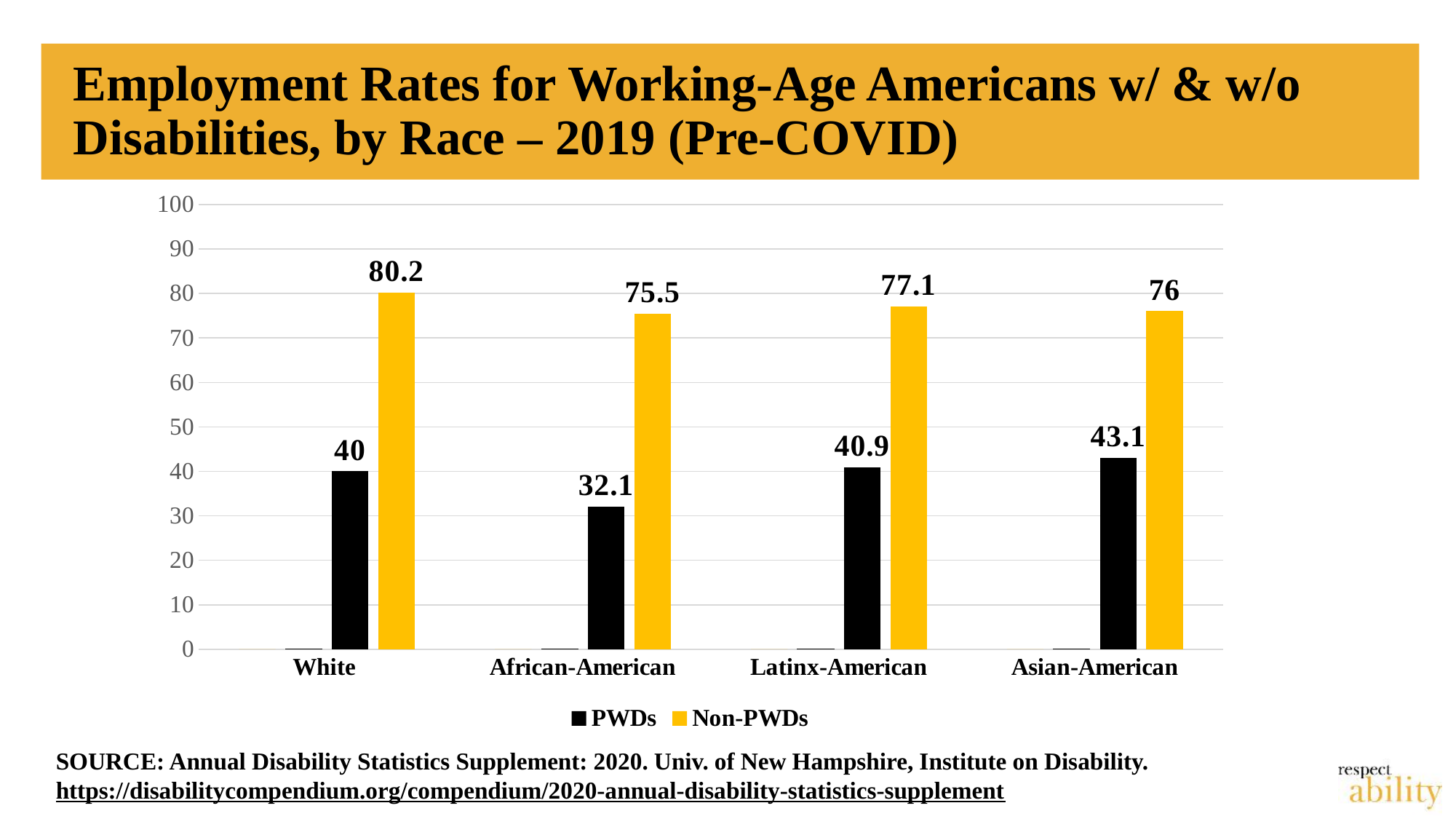
What is the employment rate for Non-PWDs in the Asian-American category? 76 Which race category has the lowest employment rate for PWDs? African-American How many series does the legend list? 2 Which race category has the highest employment rate for Non-PWDs? White Which is larger: the PWDs employment rate for Asian-American or for Latinx-American? Asian-American What is the difference between the Non-PWDs and PWDs employment rates for the White category? 40.2 Which colour represents the Non-PWDs series? Yellow What is the employment rate for PWDs in the Latinx-American category? 40.9 How many race categories are shown on the x axis? 4 What kind of chart is shown on the slide? Bar chart What is the employment rate for PWDs in the White category? 40 What is the employment rate for Non-PWDs in the African-American category? 75.5